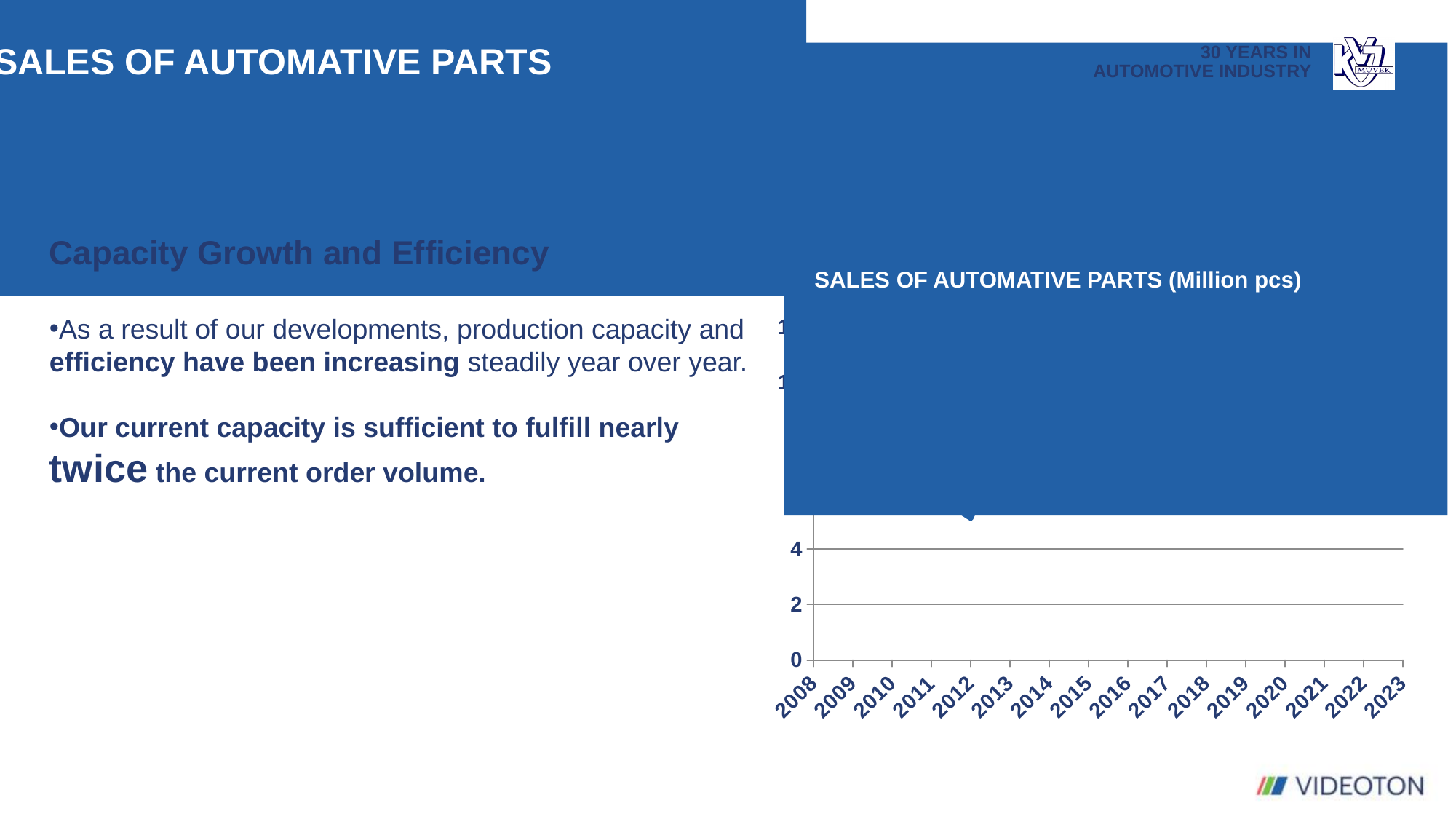
How many years are shown on the x axis of the chart? 16 What is the title of the chart on the slide? SALES OF AUTOMATIVE PARTS (Million pcs) Is the value for 2012 greater or less than 4? greater What is the lowest tick value shown on the y axis of the chart? 0 What is the first year shown on the x axis of the chart? 2008 In what unit are the values of the chart expressed, according to its title? Million pcs What is the last year shown on the x axis of the chart? 2023